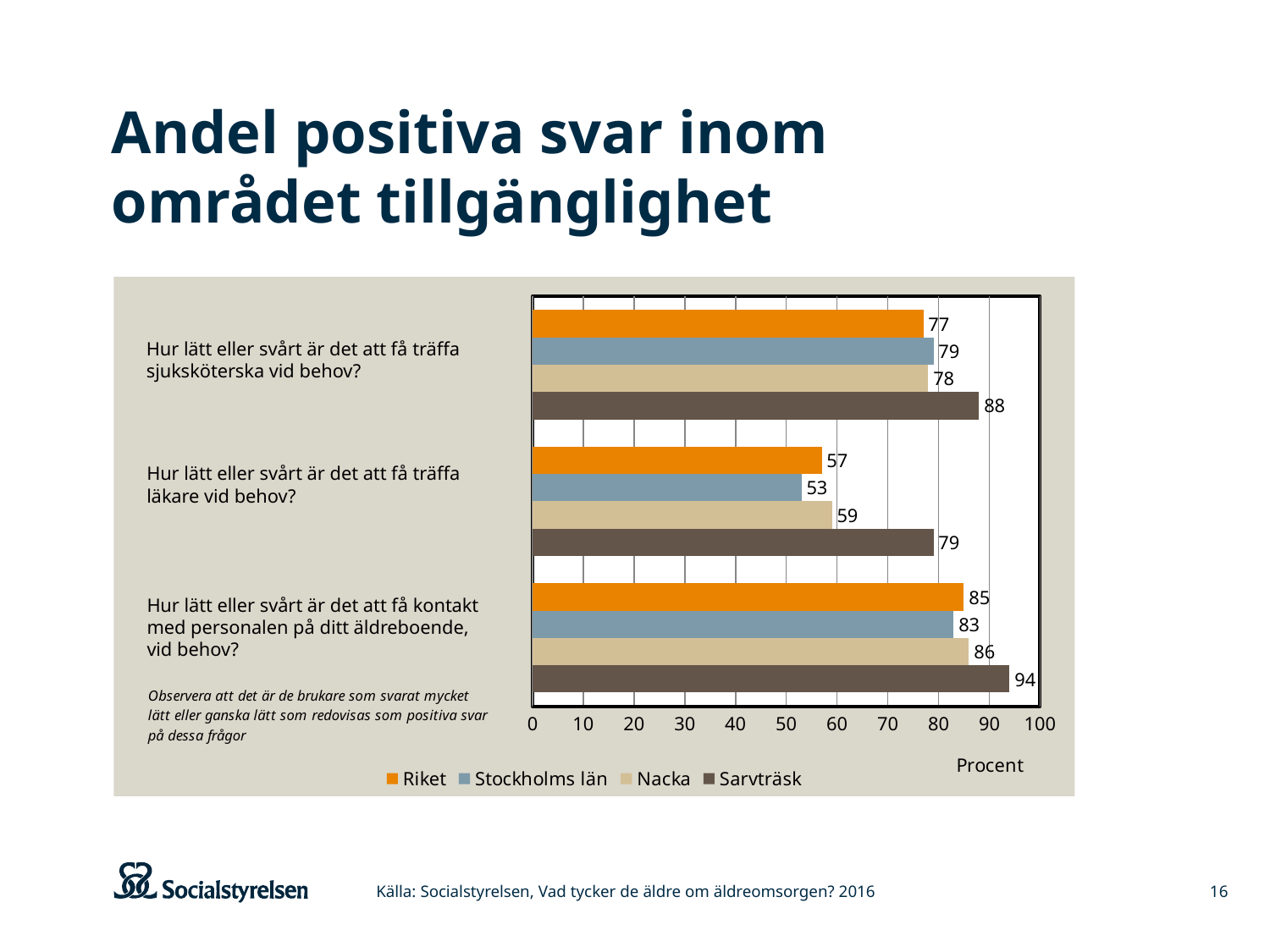
What is the value for Sarvträsk on the question "Hur lätt eller svårt är det att få träffa sjuksköterska vid behov?"? 88 How many series does the legend list? 4 What is the label of the horizontal axis? Procent What kind of chart is shown on the slide? Bar chart Which is larger on the question "Hur lätt eller svårt är det att få träffa sjuksköterska vid behov?": Riket or Nacka? Nacka Is the value for Sarvträsk on the question "Hur lätt eller svårt är det att få kontakt med personalen på ditt äldreboende, vid behov?" greater or less than 90? greater Which series has the lowest value on the question "Hur lätt eller svårt är det att få kontakt med personalen på ditt äldreboende, vid behov?"? Stockholms län How many questions (categories) are shown on the chart? 3 What is the value for Nacka on the question "Hur lätt eller svårt är det att få kontakt med personalen på ditt äldreboende, vid behov?"? 86 What is the difference between Sarvträsk and Riket on the question "Hur lätt eller svårt är det att få träffa läkare vid behov?"? 22 Which series has the highest value on the question "Hur lätt eller svårt är det att få träffa läkare vid behov?"? Sarvträsk What is the value for Stockholms län on the question "Hur lätt eller svårt är det att få träffa läkare vid behov?"? 53